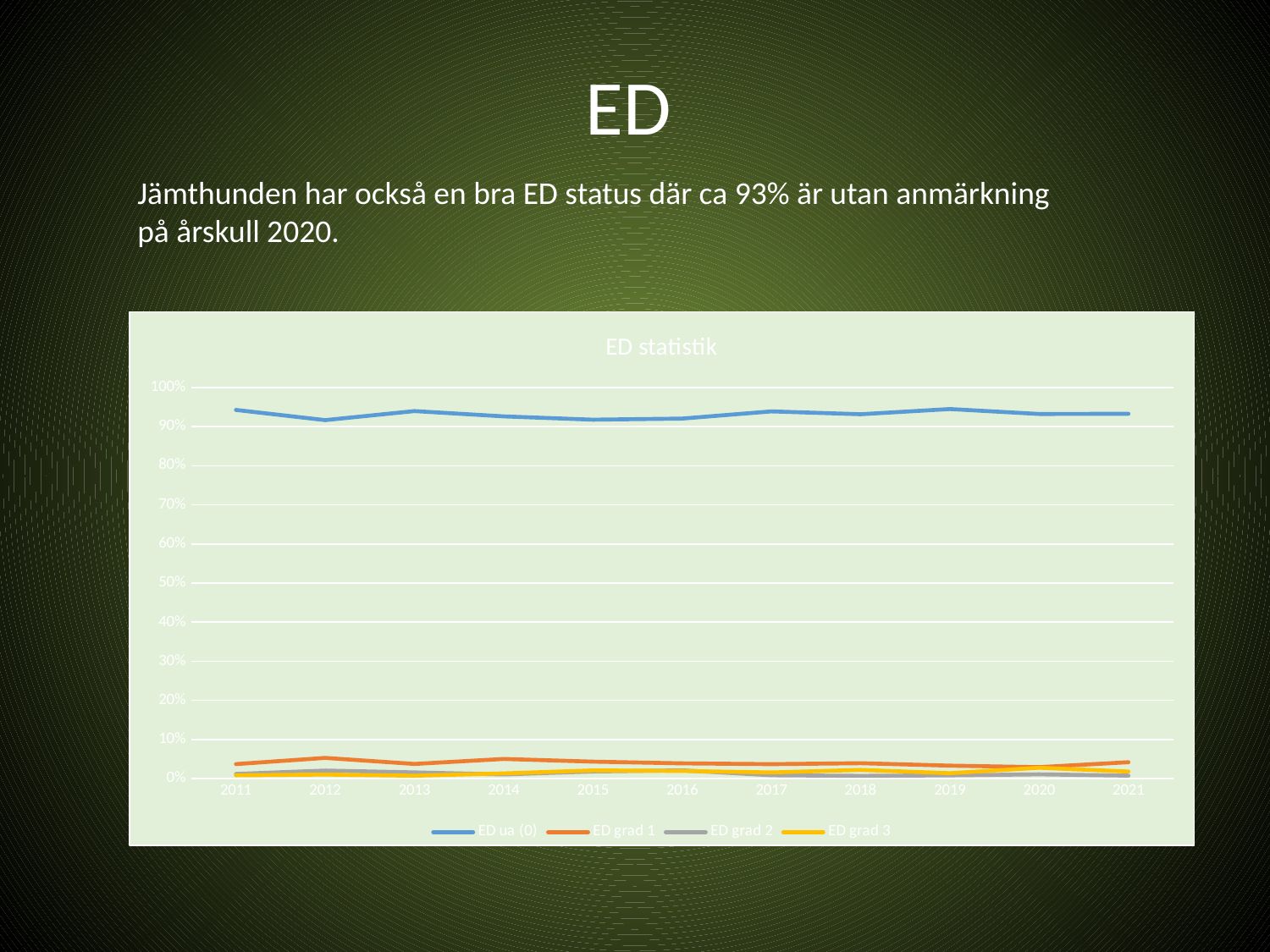
How many years are shown on the x axis? 11 Is the value for ED grad 3 in 2016 greater or less than 10%? less Which series is plotted with the blue line? ED ua (0) Which is larger in 2015, ED ua (0) or ED grad 1? ED ua (0) Is the value for ED ua (0) in 2019 greater or less than 90%? greater What kind of chart is shown on the slide? line chart Is the value for ED grad 1 in 2012 greater or less than 10%? less Which is larger in 2021, ED grad 1 or ED grad 2? ED grad 1 How many series does the legend list? 4 Which series has the highest value in 2020? ED ua (0) What is the title of the chart? ED statistik